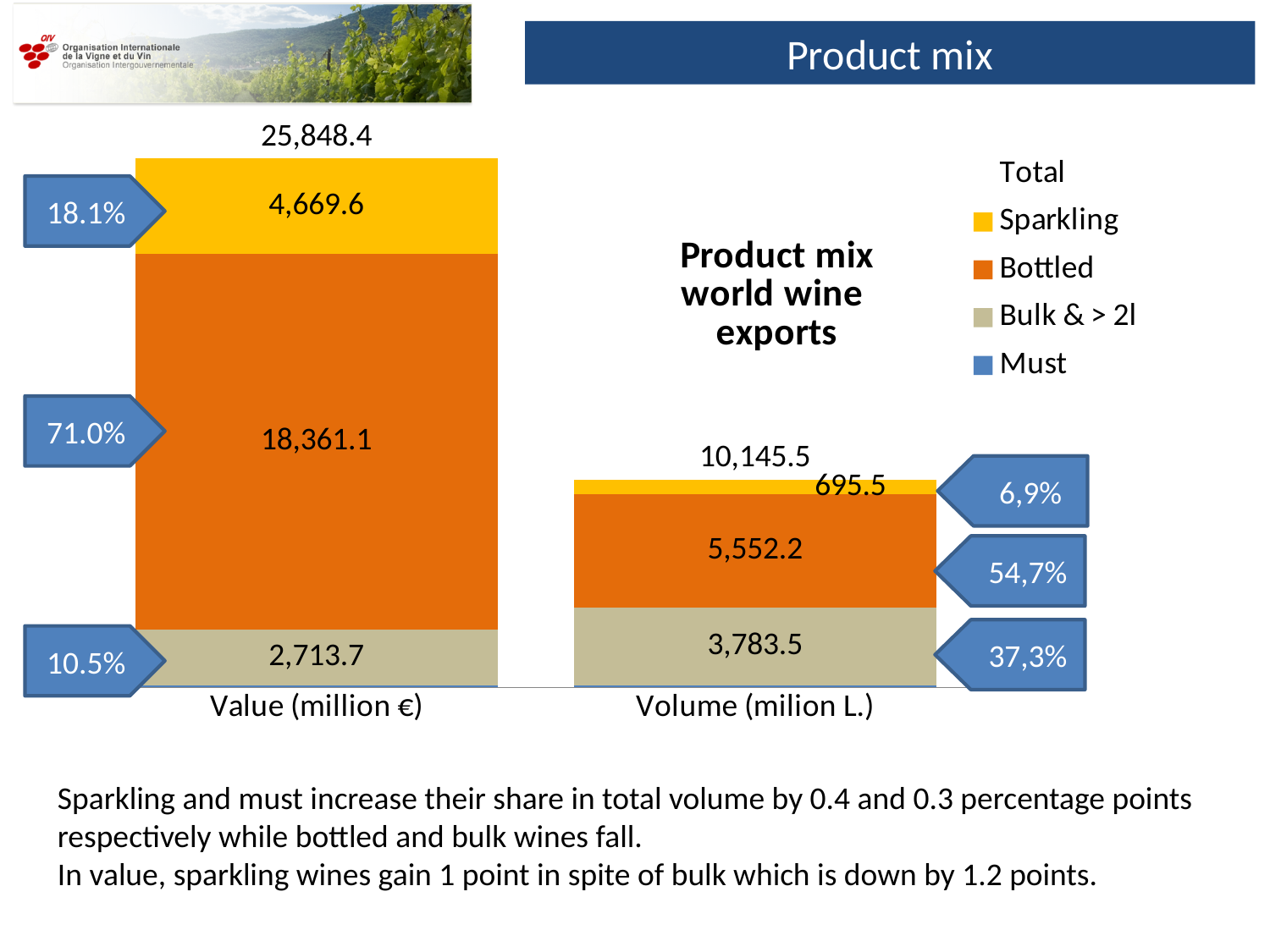
In the Volume (milion L.) bar, which is larger: Bottled or Bulk & > 2l? Bottled What kind of chart is shown on the slide? Stacked bar chart How many bars (categories) are plotted on the x axis? 2 What is the total shown above the Volume (milion L.) bar? 10,145.5 What is the Sparkling value in the Volume (milion L.) bar? 695.5 What percentage share is shown in the callout for Bottled wine in the Value (million €) bar? 71.0% What is the difference between the Bottled and Bulk & > 2l values in the Volume (milion L.) bar? 1,768.7 What is the total shown above the Value (million €) bar? 25,848.4 Which product category has the largest segment in the Value (million €) bar? Bottled What is the value of Bottled wine in the Value (million €) bar? 18,361.1 What is the value of Bulk & > 2l in the Value (million €) bar? 2,713.7 What is the difference between the Bottled and Sparkling values in the Value (million €) bar? 13,691.5